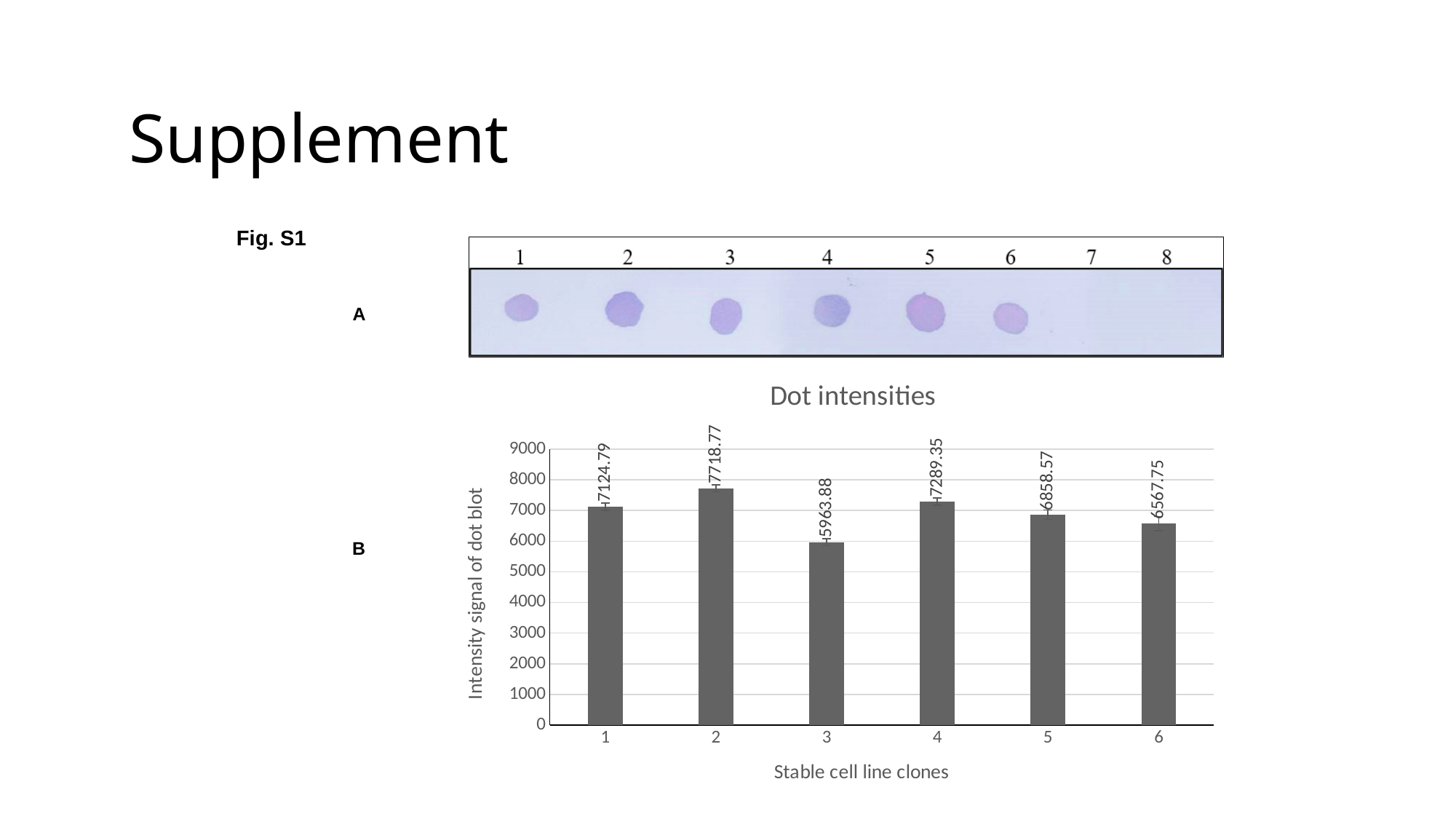
What is the difference between the intensity signals of clone 4 and clone 1 in the Dot intensities chart? 164.56 What kind of chart is the Dot intensities chart? bar chart Which clone has the highest intensity signal in the Dot intensities chart? 2 In the Dot intensities chart, which has a larger intensity signal, clone 1 or clone 4? 4 Which clone has the lowest intensity signal in the Dot intensities chart? 3 How many stable cell line clones are plotted in the Dot intensities chart? 6 What is the difference between the intensity signals of clone 2 and clone 3 in the Dot intensities chart? 1754.89 What is the y-axis label of the Dot intensities chart? Intensity signal of dot blot What is the intensity signal for clone 6 in the Dot intensities chart? 6567.75 What is the intensity signal for clone 5 in the Dot intensities chart? 6858.57 What is the intensity signal for stable cell line clone 2 in the Dot intensities chart? 7718.77 In the Dot intensities chart, is the value for clone 3 greater or less than 6000? less